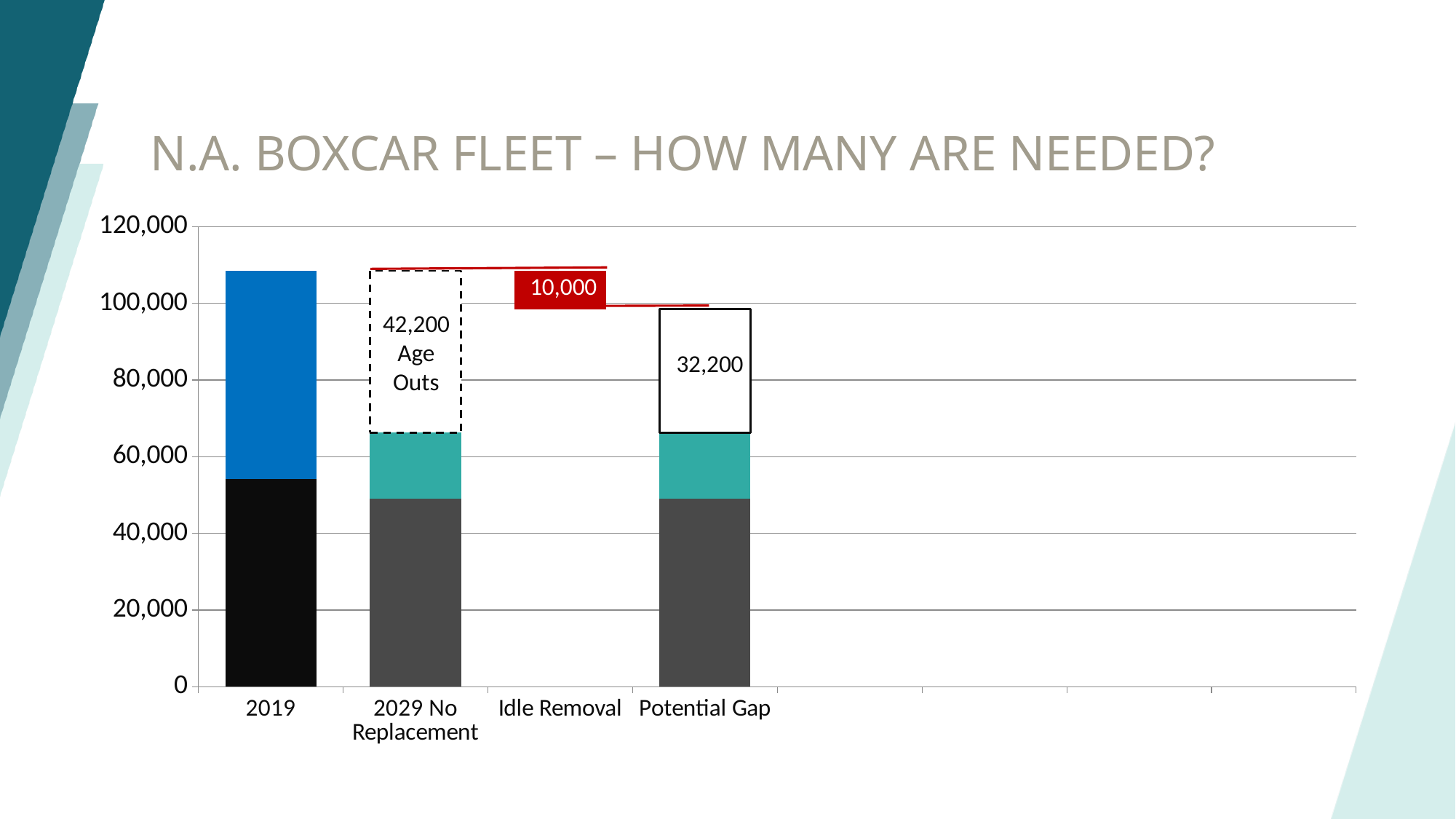
What value is labelled on the Age Outs segment of the 2029 No Replacement bar? 42,200 Is the dark grey bottom segment of the 2029 No Replacement bar greater or less than 60,000? less What is the difference between the Age Outs value (42,200) and the Idle Removal value (10,000)? 32,200 What kind of chart is shown on the slide? Stacked bar chart Is the total height of the 2019 bar greater or less than 100,000? greater What is the title of the slide? N.A. BOXCAR FLEET – HOW MANY ARE NEEDED? How many categories are labelled on the x axis? 4 What value is labelled for Idle Removal? 10,000 What value is labelled on the top segment of the Potential Gap bar? 32,200 Is the black bottom segment of the 2019 bar greater or less than 40,000? greater Which is larger, the Age Outs value in the 2029 No Replacement bar or the labelled value in the Potential Gap bar? Age Outs (42,200)